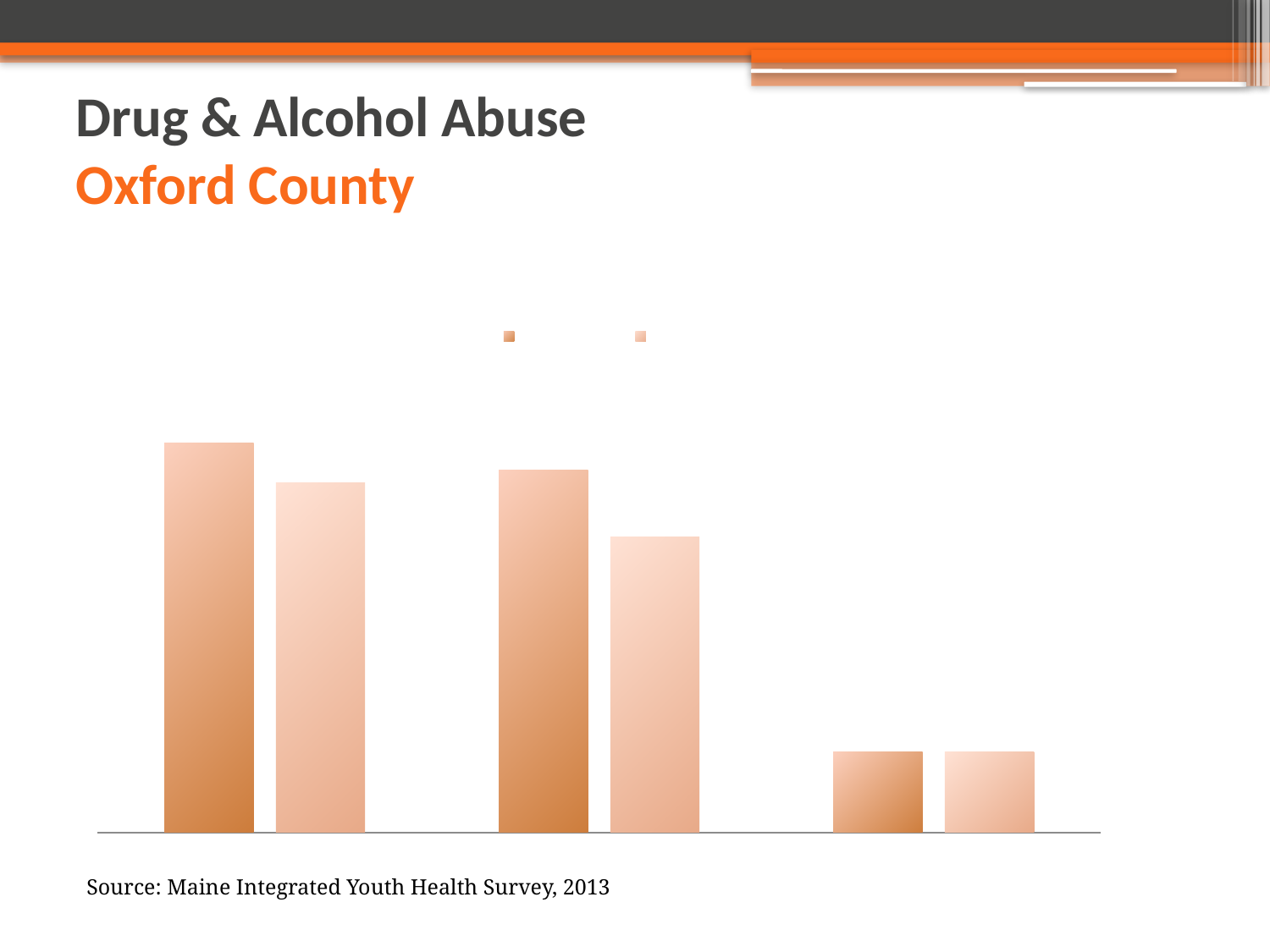
Which group of bars has the lowest values, the leftmost, middle, or rightmost group? the rightmost group Which group of bars has the highest values, the leftmost, middle, or rightmost group? the leftmost group What kind of chart is shown on the slide? bar chart What source is cited below the chart? Maine Integrated Youth Health Survey, 2013 How many series does the legend list? 2 Do the lighter orange bars rise or fall from left to right across the chart? fall How many bars are plotted in total in the chart? 6 What is the title of the slide containing the chart? Drug & Alcohol Abuse Oxford County How many groups of bars are plotted in the chart? 3 In the middle group of bars, which bar is taller, the darker orange bar or the lighter orange bar? the darker orange bar Do the darker orange bars rise or fall from left to right across the chart? fall In the leftmost group of bars, which bar is taller, the darker orange bar or the lighter orange bar? the darker orange bar